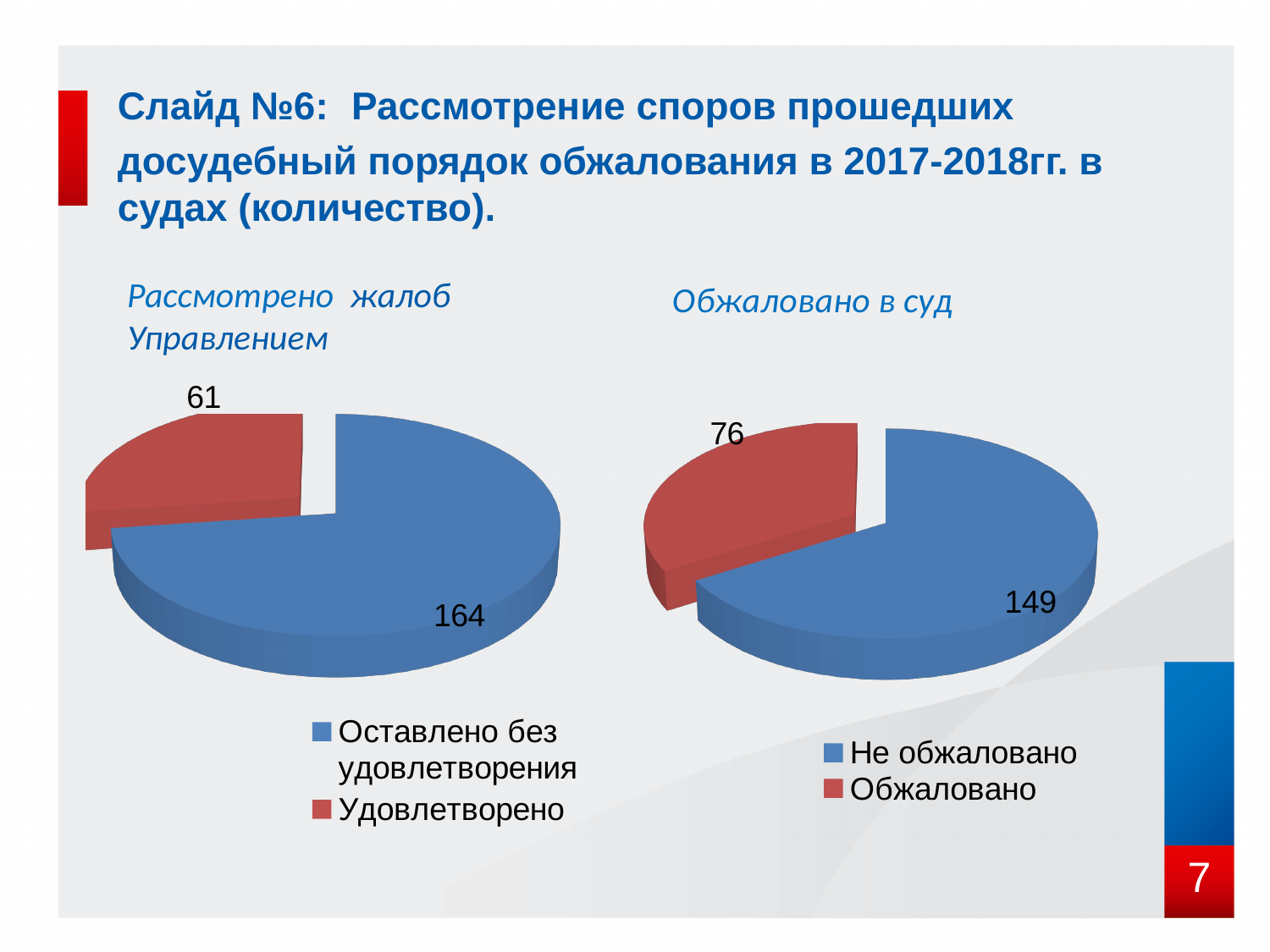
In the left chart 'Рассмотрено жалоб Управлением', what colour is the 'Удовлетворено' slice? Red Which is larger: 'Удовлетворено' in the left chart or 'Обжаловано' in the right chart? Обжаловано In the left chart 'Рассмотрено жалоб Управлением', what is the value for 'Оставлено без удовлетворения'? 164 In the right chart 'Обжаловано в суд', which category has the smallest slice? Обжаловано In the right chart 'Обжаловано в суд', what is the value for 'Обжаловано'? 76 How many categories does the right chart 'Обжаловано в суд' show? 2 In the left chart 'Рассмотрено жалоб Управлением', which category has the largest slice? Оставлено без удовлетворения In the right chart 'Обжаловано в суд', what is the value for 'Не обжаловано'? 149 What type of chart is used on this slide? Pie chart In the left chart 'Рассмотрено жалоб Управлением', what is the difference between 'Оставлено без удовлетворения' and 'Удовлетворено'? 103 In the left chart 'Рассмотрено жалоб Управлением', what is the value for 'Удовлетворено'? 61 In the right chart 'Обжаловано в суд', what is the difference between 'Не обжаловано' and 'Обжаловано'? 73